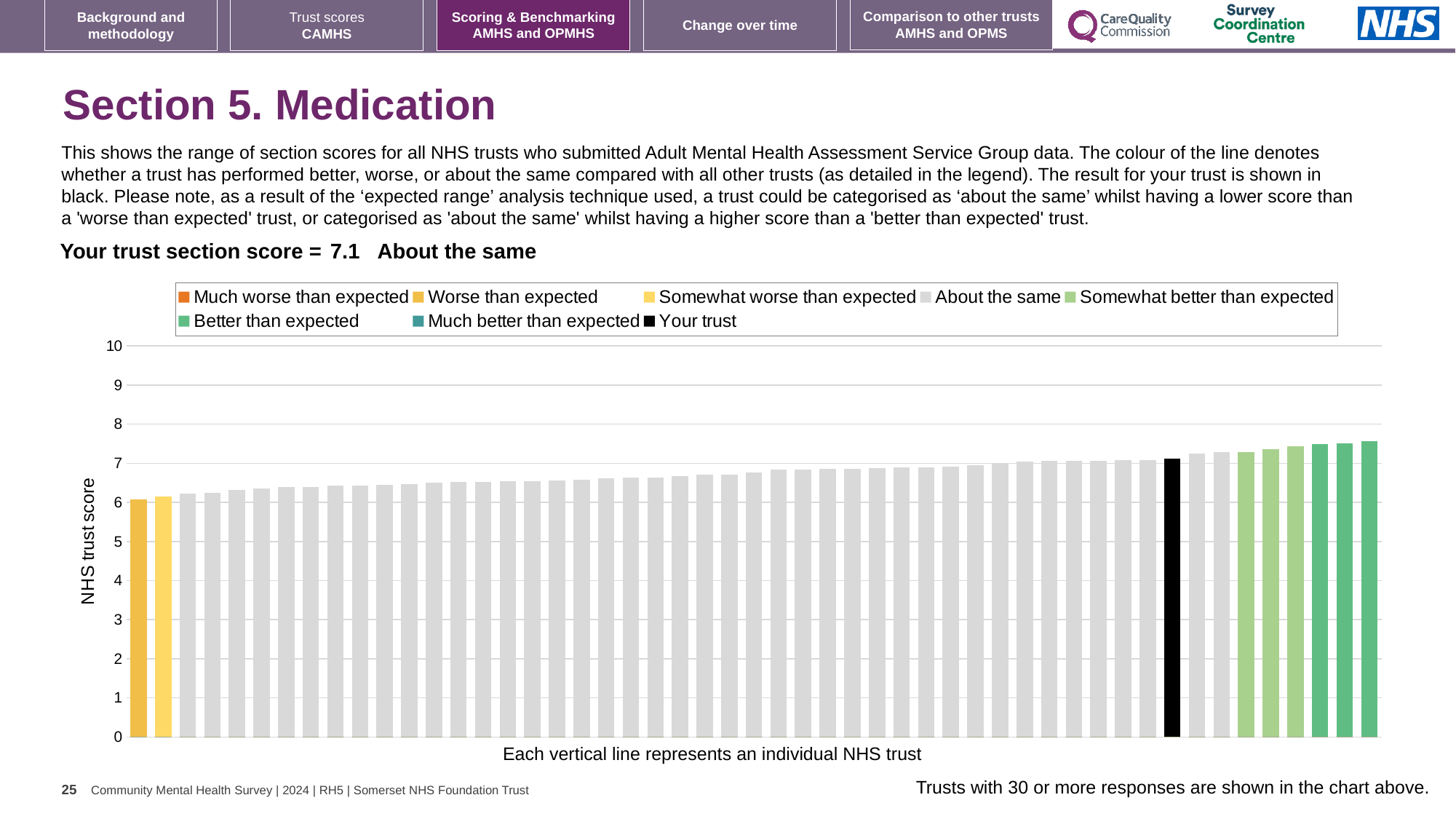
What is the label on the vertical axis of the chart? NHS trust score Is the value of the rightmost bar greater or less than 7? greater How many series does the chart legend list? 8 Do the bar values rise or fall from left to right along the x axis? rise Which category is your trust's section score placed in? About the same Is the value of the black 'Your trust' bar greater or less than 5? greater Is the value of the leftmost bar greater or less than 7? less Which is larger: the value of the black 'Your trust' bar or the value of the leftmost bar? Your trust How many bars are coloured as 'Worse than expected'? 1 What is the section score for your trust shown on the slide? 7.1 What kind of chart is shown on the slide? bar chart What colour is used for the 'Your trust' bar? black